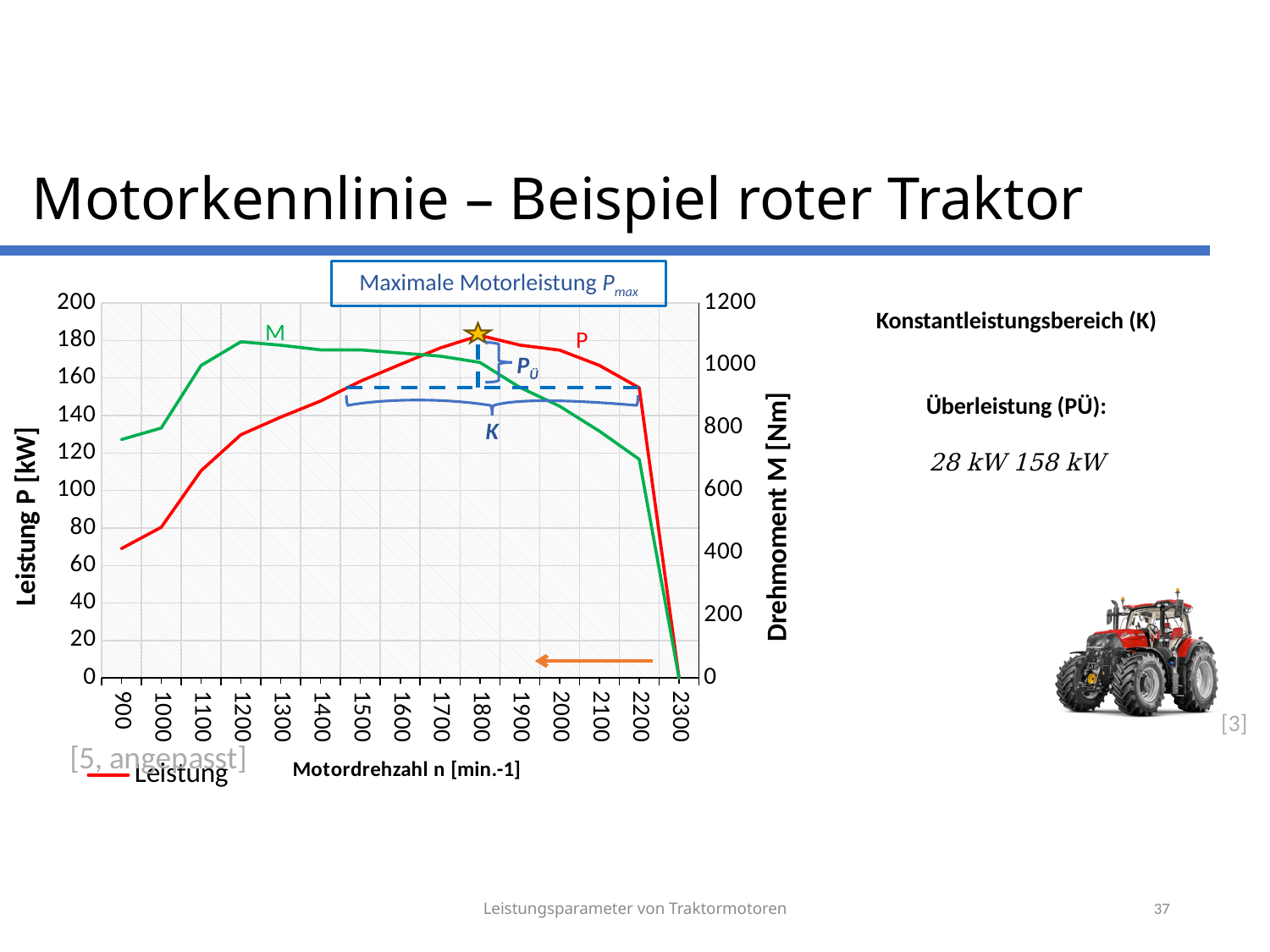
Is the Leistung value at 2200 min-1 greater or less than 140 kW? greater Does the Leistung curve rise or fall between 900 and 1800 min-1? rise What kind of chart is shown on the slide? line chart Is the Leistung value at 900 min-1 greater or less than 80 kW? less What is the label of the right-hand y axis? Drehmoment M [Nm] Is the Drehmoment value at 2200 min-1 greater or less than 800 Nm? less At which Motordrehzahl does the Drehmoment (M) curve reach its maximum? 1200 How many tick labels are shown on the Motordrehzahl x axis? 15 At which Motordrehzahl does the Leistung (P) curve reach its maximum? 1800 Which is larger, the Leistung at 1200 min-1 or the Leistung at 1100 min-1? 1200 min-1